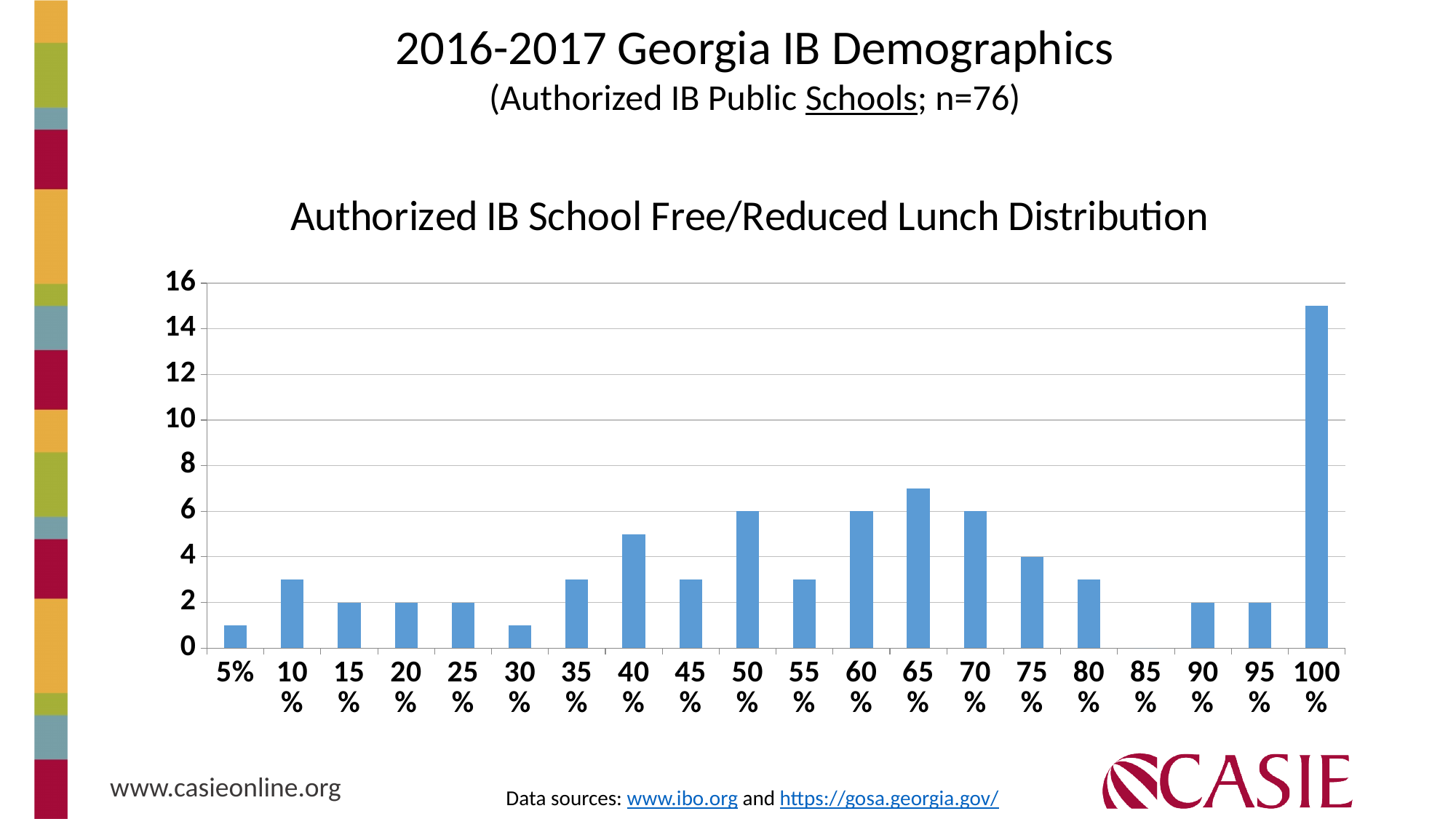
What is the title of the chart? Authorized IB School Free/Reduced Lunch Distribution What is the value for the 75% category? 4 Which category has the highest bar? 100% What is the value for the 90% category? 2 How many categories are shown on the x axis? 20 Which is larger, the value for 40% or the value for 45%? 40% What is the difference between the values for 70% and 75%? 2 What is the value for the 50% category? 6 Which category has no bar at all (a value of zero)? 85% Is the value for 100% greater or less than 14? greater What kind of chart is shown on the slide? bar chart